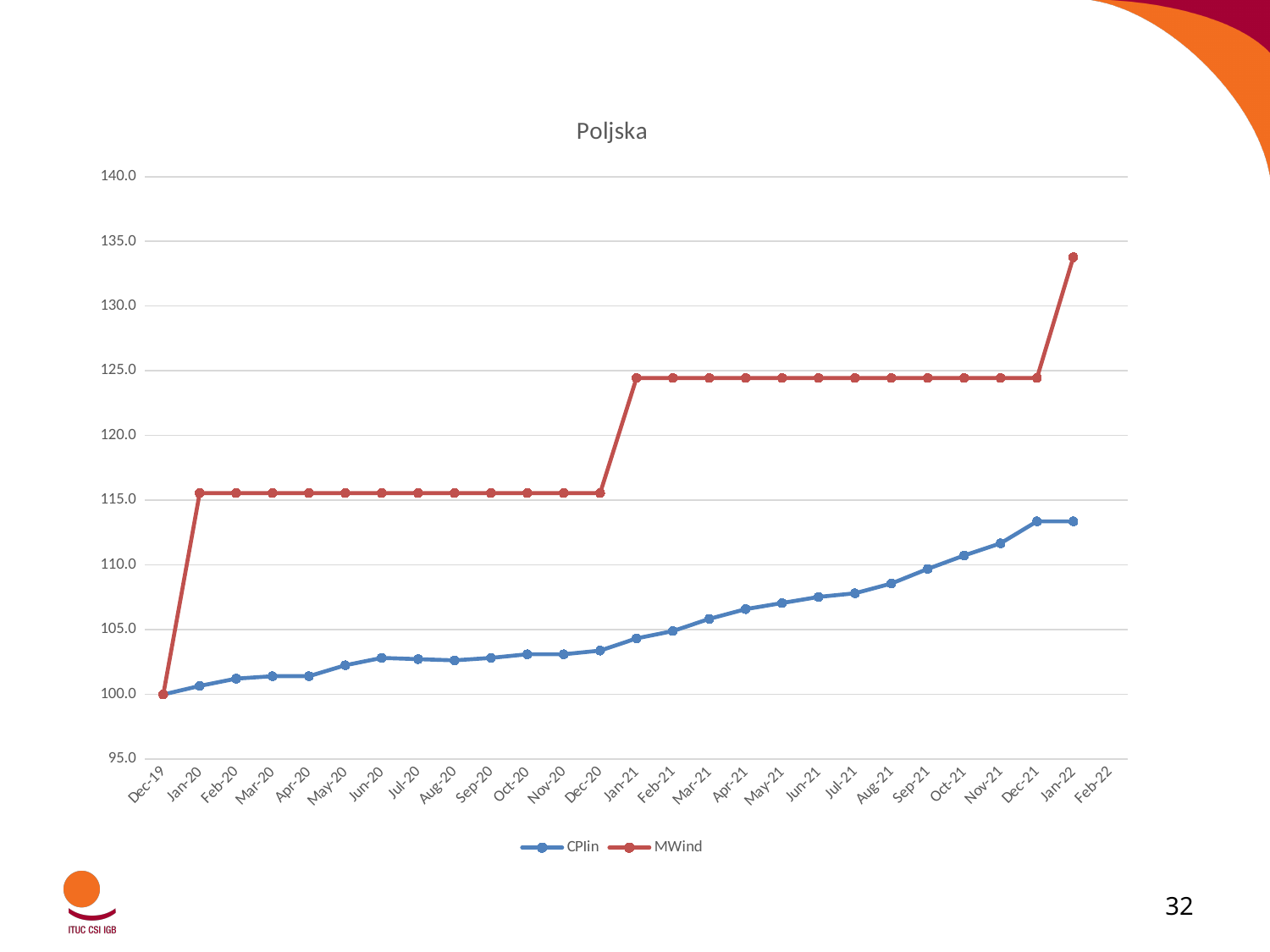
In which month does MWind reach its highest value? Jan-22 What is the value of MWind in Dec-19? 100.0 Does the CPlin series generally rise or fall from Dec-19 to Jan-22? rise What are the two series named in the legend? CPlin and MWind How many series does the legend list? 2 Is the value for CPlin in Jan-22 greater or less than 115.0? less What is the title of the chart? Poljska Is the value for MWind in Jan-22 greater or less than 130.0? greater What kind of chart is shown on the slide? line chart Which series has the larger value in Jan-22, CPlin or MWind? MWind What is the value of CPlin in Dec-19? 100.0 Is the value for MWind in Jun-20 greater or less than 120.0? less